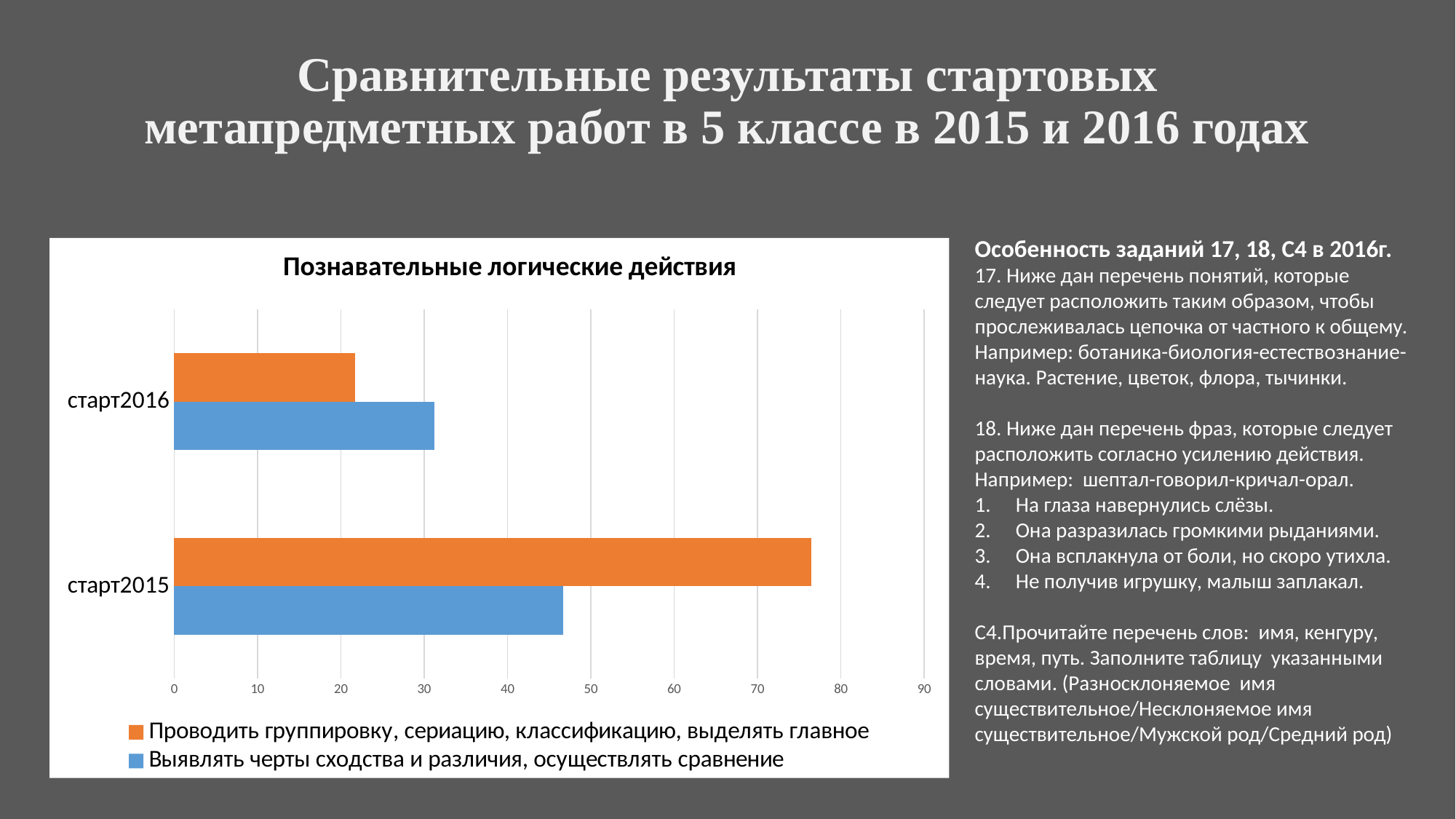
Is the value for "Проводить группировку, сериацию, классификацию, выделять главное" in старт2016 greater or less than 30? less Which category has the highest value for "Проводить группировку, сериацию, классификацию, выделять главное"? старт2015 For старт2016, which series has the larger value: "Проводить группировку, сериацию, классификацию, выделять главное" or "Выявлять черты сходства и различия, осуществлять сравнение"? Выявлять черты сходства и различия, осуществлять сравнение What is the title of the chart? Познавательные логические действия Is the value for "Проводить группировку, сериацию, классификацию, выделять главное" in старт2015 greater or less than 70? greater What kind of chart is shown on the slide? bar chart Which colour represents the series "Выявлять черты сходства и различия, осуществлять сравнение"? blue Is the value for "Выявлять черты сходства и различия, осуществлять сравнение" in старт2016 greater or less than 40? less How many categories are plotted on the chart? 2 For старт2015, which series has the larger value: "Проводить группировку, сериацию, классификацию, выделять главное" or "Выявлять черты сходства и различия, осуществлять сравнение"? Проводить группировку, сериацию, классификацию, выделять главное How many series does the chart legend list? 2